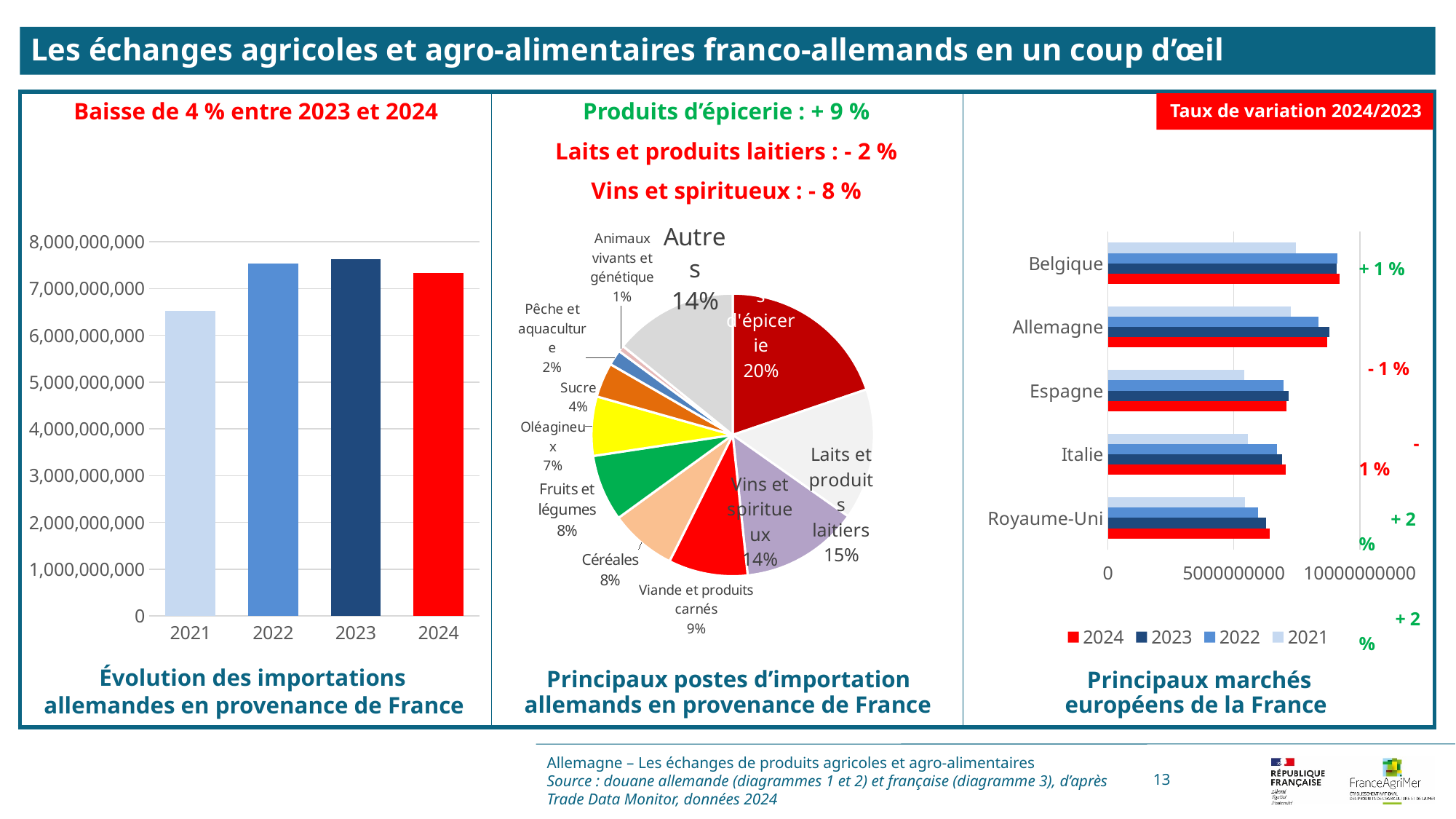
In the middle pie chart 'Principaux postes d'importation allemands en provenance de France', what share does 'Produits d'épicerie' have? 20% In the middle pie chart 'Principaux postes d'importation allemands en provenance de France', what is the difference in percentage points between 'Produits d'épicerie' and 'Vins et spiritueux'? 6 In the right chart 'Principaux marchés européens de la France', which country has the highest value for 2024? Belgique In the middle pie chart 'Principaux postes d'importation allemands en provenance de France', what share does 'Laits et produits laitiers' have? 15% In the right chart 'Principaux marchés européens de la France', how many series does the legend list? 4 In the middle pie chart 'Principaux postes d'importation allemands en provenance de France', which slice is the smallest? Animaux vivants et génétique In the left chart 'Évolution des importations allemandes en provenance de France', is the value for 2024 greater or less than 7,000,000,000? greater In the middle pie chart 'Principaux postes d'importation allemands en provenance de France', how many slices are there? 11 What kind of chart is the left chart, 'Évolution des importations allemandes en provenance de France'? bar chart In the left chart 'Évolution des importations allemandes en provenance de France', which year has the lowest value? 2021 In the left chart 'Évolution des importations allemandes en provenance de France', is the value for 2021 greater or less than 7,000,000,000? less In the left chart 'Évolution des importations allemandes en provenance de France', how many years are shown? 4